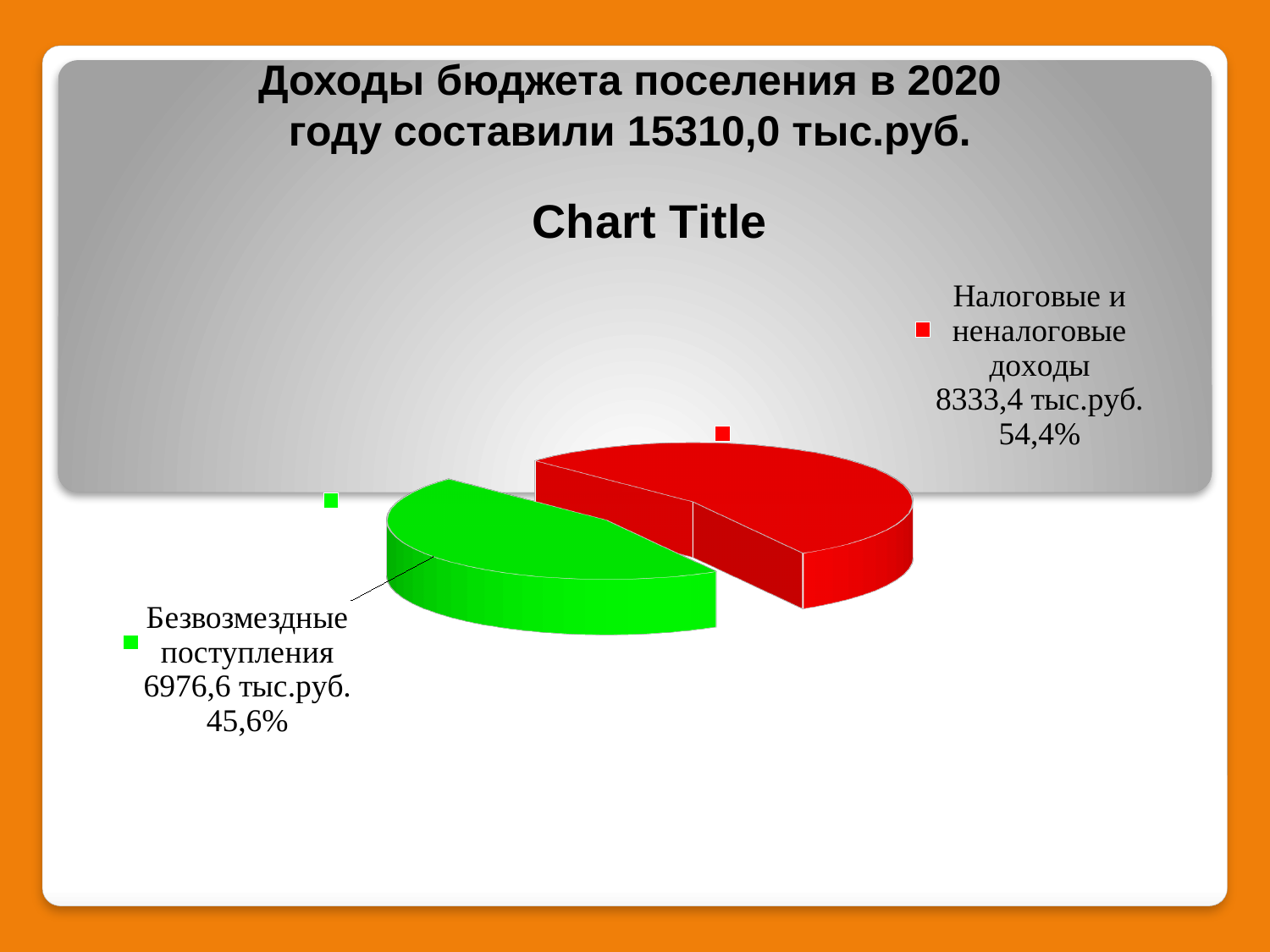
What colour is the slice for Безвозмездные поступления? green Which slice is the smallest? Безвозмездные поступления How many slices does the pie chart have? 2 What kind of chart is shown on the slide? pie chart What is the value for Налоговые и неналоговые доходы? 8333,4 тыс.руб. What is the title shown above the pie chart? Chart Title Which is larger, Налоговые и неналоговые доходы or Безвозмездные поступления? Налоговые и неналоговые доходы Which slice is the largest? Налоговые и неналоговые доходы What is the value for Безвозмездные поступления? 6976,6 тыс.руб. What is the difference in percentage points between the share of Налоговые и неналоговые доходы and the share of Безвозмездные поступления? 8,8 What share of the pie does Налоговые и неналоговые доходы represent? 54,4% What share of the pie does Безвозмездные поступления represent? 45,6%